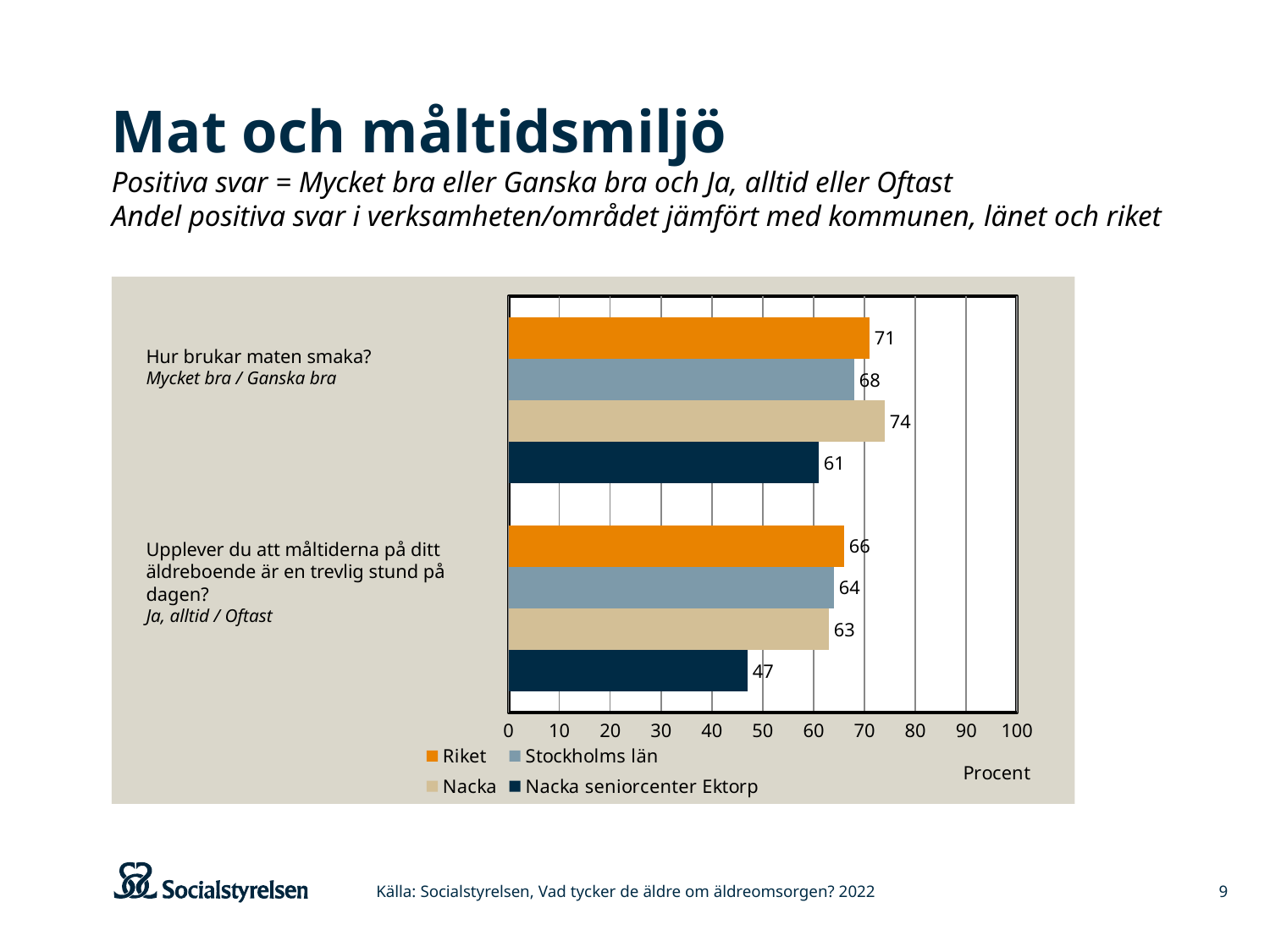
What value is shown for Nacka on the question 'Hur brukar maten smaka?' 74 Which series has the highest value for the question 'Hur brukar maten smaka?' Nacka What value is shown for Riket on the question 'Upplever du att måltiderna på ditt äldreboende är en trevlig stund på dagen?' 66 What value is shown for Nacka seniorcenter Ektorp on the question 'Hur brukar maten smaka?' 61 What kind of chart is shown on the slide? Bar chart What is the label on the horizontal axis of the chart? Procent Which series has the lowest value for the question 'Upplever du att måltiderna på ditt äldreboende är en trevlig stund på dagen?' Nacka seniorcenter Ektorp How many series does the legend list? 4 Which is larger for 'Hur brukar maten smaka?': the Riket value or the Stockholms län value? Riket What is the difference between the Riket value and the Nacka seniorcenter Ektorp value for 'Upplever du att måltiderna på ditt äldreboende är en trevlig stund på dagen?' 19 What is the difference between the Nacka value and the Nacka seniorcenter Ektorp value for 'Hur brukar maten smaka?' 13 What value is shown for Stockholms län on the question 'Upplever du att måltiderna på ditt äldreboende är en trevlig stund på dagen?' 64